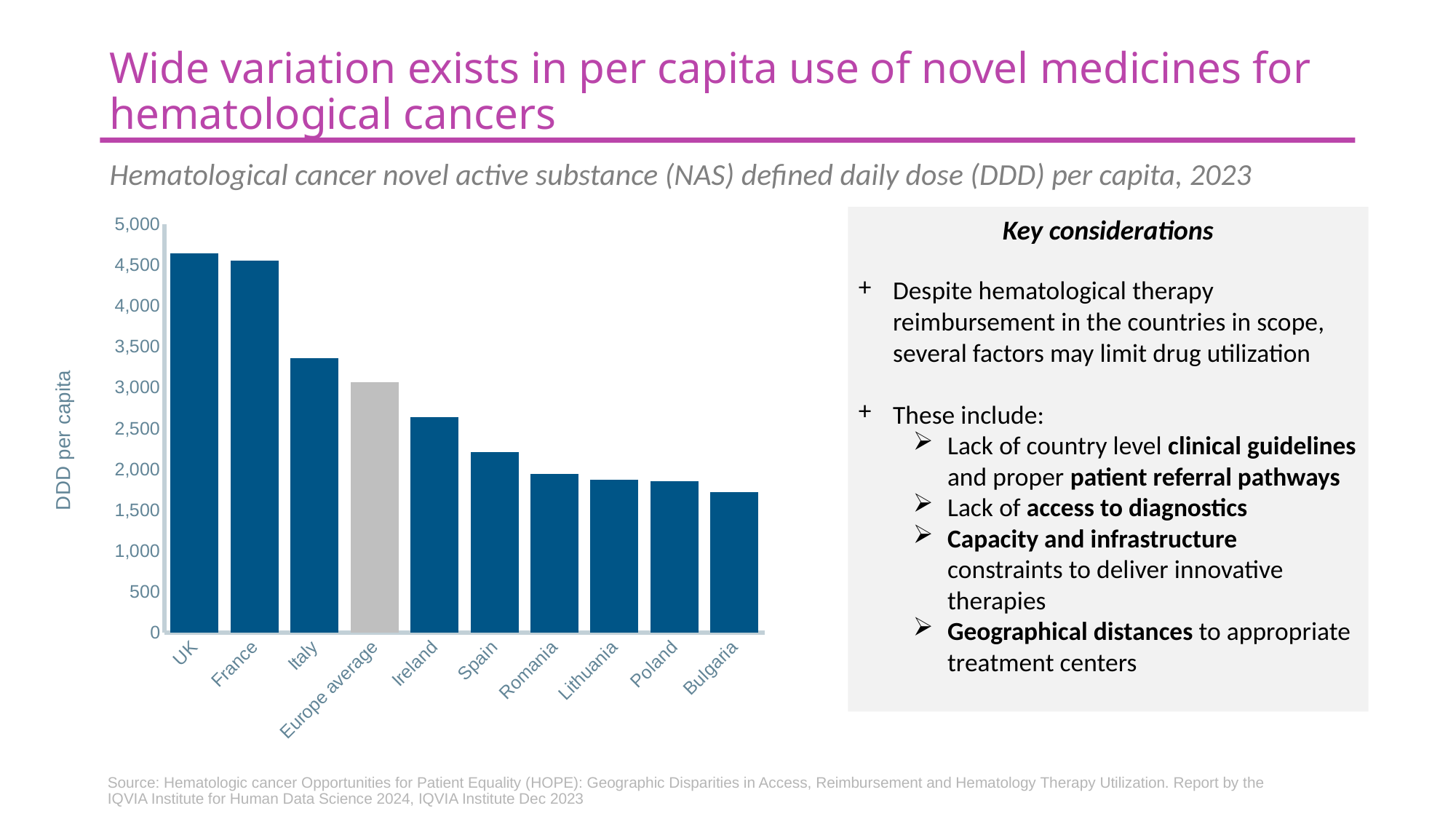
Is the value for Spain greater or less than 2,500? less Which category has the lowest DDD per capita in the chart? Bulgaria Is the value for Italy greater or less than 3,000? greater Do the values rise or fall moving from left to right along the x axis? fall How many categories are plotted on the x axis of the chart? 10 Is the value for Europe average greater or less than 3,500? less What kind of chart is shown on the slide? bar chart Which bar in the chart is coloured grey instead of blue? Europe average Which is larger, the value for Italy or the value for Ireland? Italy